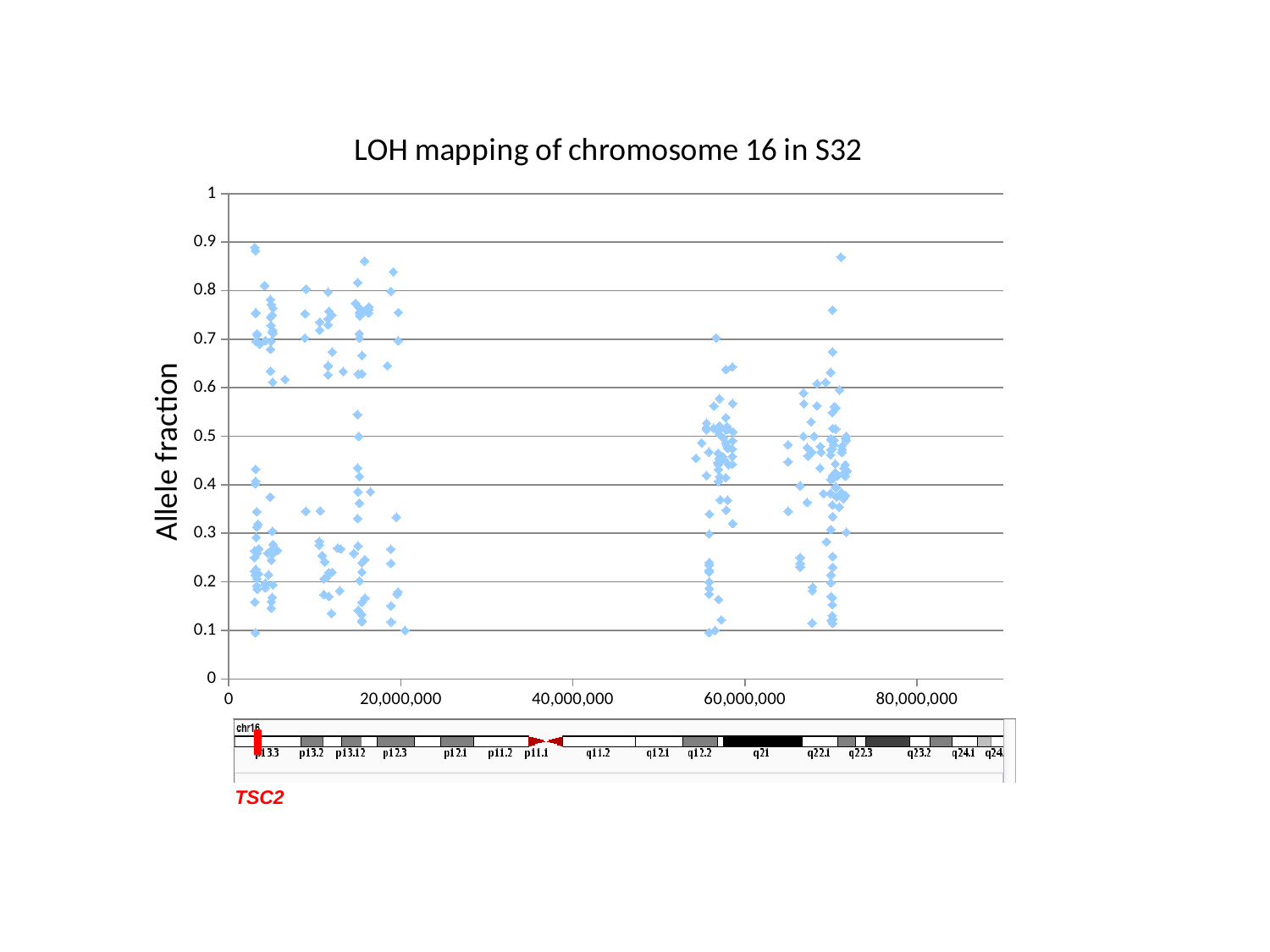
What is the largest tick label shown on the horizontal axis? 80,000,000 Which gene is labelled in red beneath the chromosome ideogram? TSC2 What is the interval between consecutive tick labels on the vertical axis? 0.1 Is the lowest plotted allele fraction greater or less than 0.2? less What kind of chart is shown on the slide? scatter chart Is the highest plotted allele fraction greater or less than 0.8? greater What is the maximum value shown on the vertical axis? 1 What is the title of the chart? LOH mapping of chromosome 16 in S32 Are any points plotted between 30,000,000 and 50,000,000 on the horizontal axis? No